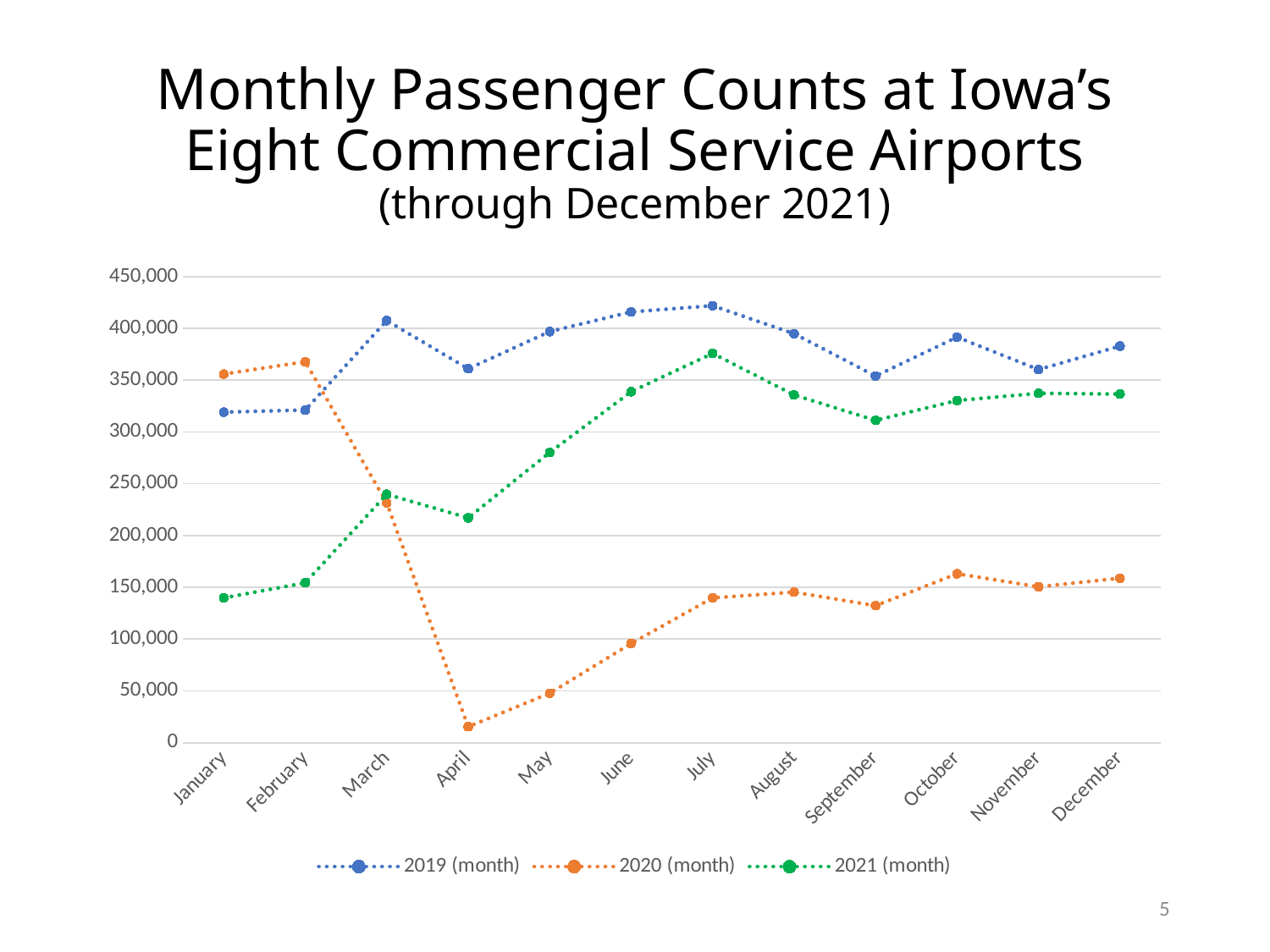
In which month is the 2021 (month) series at its highest? July Is the value for July in the 2019 (month) series greater or less than 400,000? greater In which month is the 2021 (month) series at its lowest? January Does the 2020 (month) series rise or fall from February to April? Fall In which month is the 2020 (month) series at its lowest? April What kind of chart is shown on the slide? Line chart What colour is the 2021 (month) series in the legend? Green Is the value for July in the 2021 (month) series greater or less than 350,000? greater How many months are shown along the x axis? 12 Which is larger in January: the 2020 (month) value or the 2021 (month) value? 2020 (month) Is the value for April in the 2020 (month) series greater or less than 50,000? less How many series does the legend list? 3